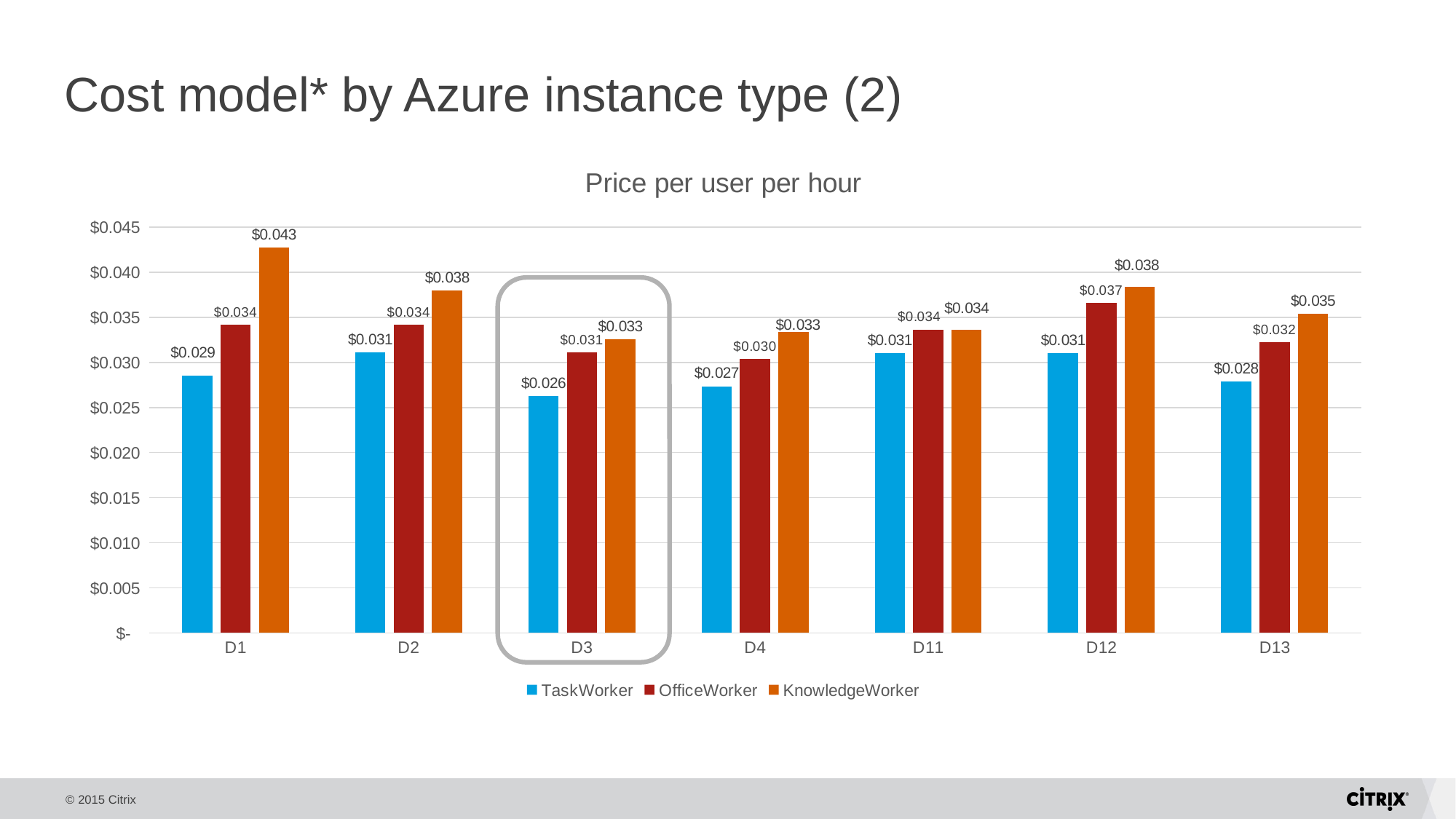
Is the KnowledgeWorker value for D1 greater or less than $0.040? greater What is the OfficeWorker price per user per hour for the D12 instance type? $0.037 Which instance type has the lowest TaskWorker price per user per hour? D3 What is the difference between the KnowledgeWorker and TaskWorker prices for the D1 instance type? $0.014 Which is larger: the KnowledgeWorker price for D2 or the KnowledgeWorker price for D13? D2 How many series does the chart legend list? 3 Which instance type has the highest KnowledgeWorker price per user per hour? D1 What is the KnowledgeWorker price per user per hour for the D1 instance type? $0.043 How many Azure instance types are shown on the x axis of the chart? 7 Which instance type is highlighted with a rounded grey outline on the chart? D3 What kind of chart is shown on the slide? Bar chart What is the TaskWorker price per user per hour for the D3 instance type? $0.026